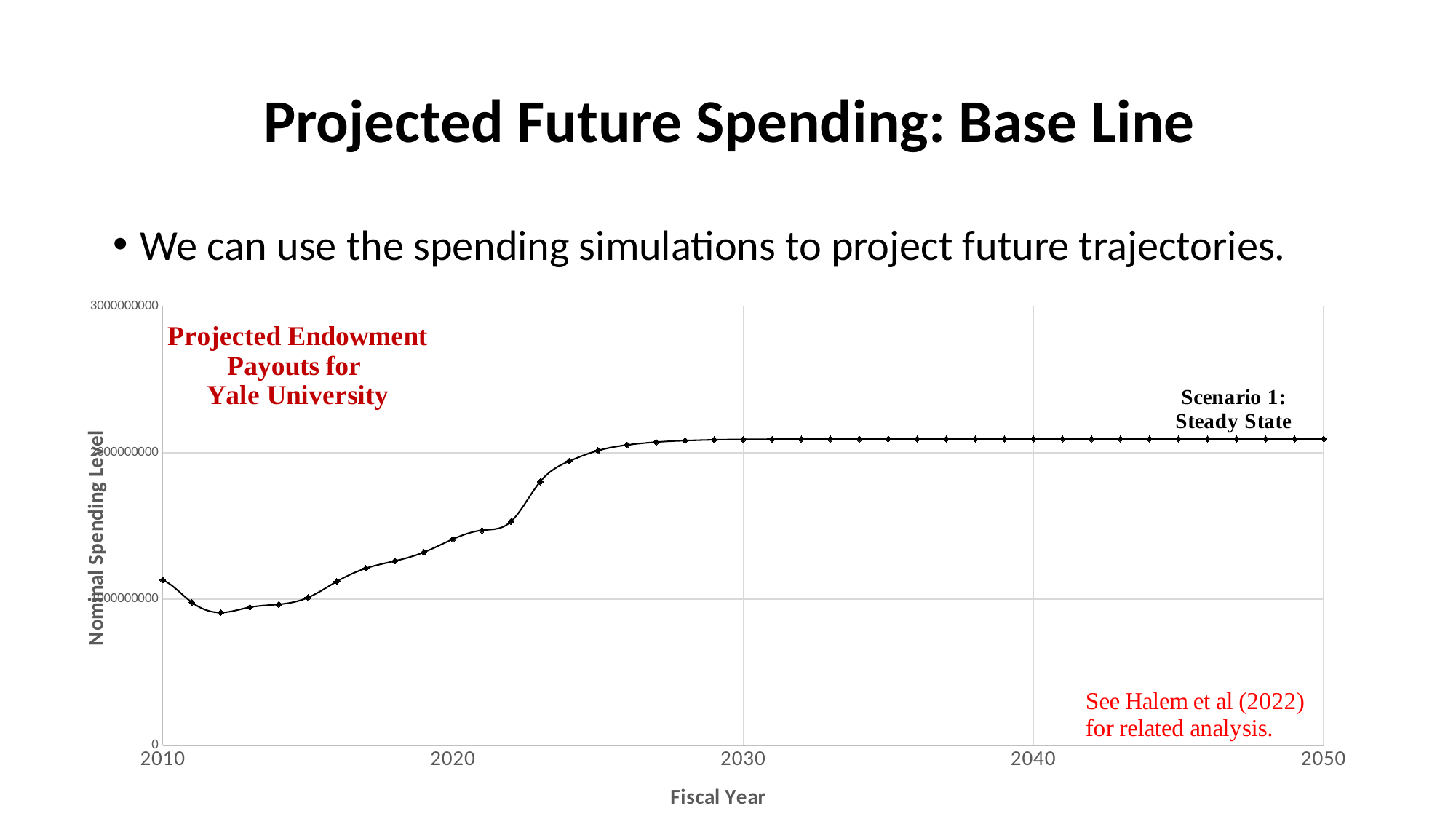
What is the title of the chart? Projected Endowment Payouts for Yale University How many data points are plotted on the line? 41 Which fiscal year has the higher spending level, 2010 or 2020? 2020 Which fiscal year has the higher spending level, 2015 or 2025? 2025 Is the value for fiscal year 2050 greater or less than 3000000000? less Does the spending level rise or fall between fiscal years 2012 and 2030? Rise Is the value for fiscal year 2012 greater or less than 1000000000? less What is the label of the x axis of the chart? Fiscal Year In which fiscal year is the projected spending level lowest? 2012 Is the value for fiscal year 2030 greater or less than 2000000000? greater What kind of chart is shown on the slide? Line chart